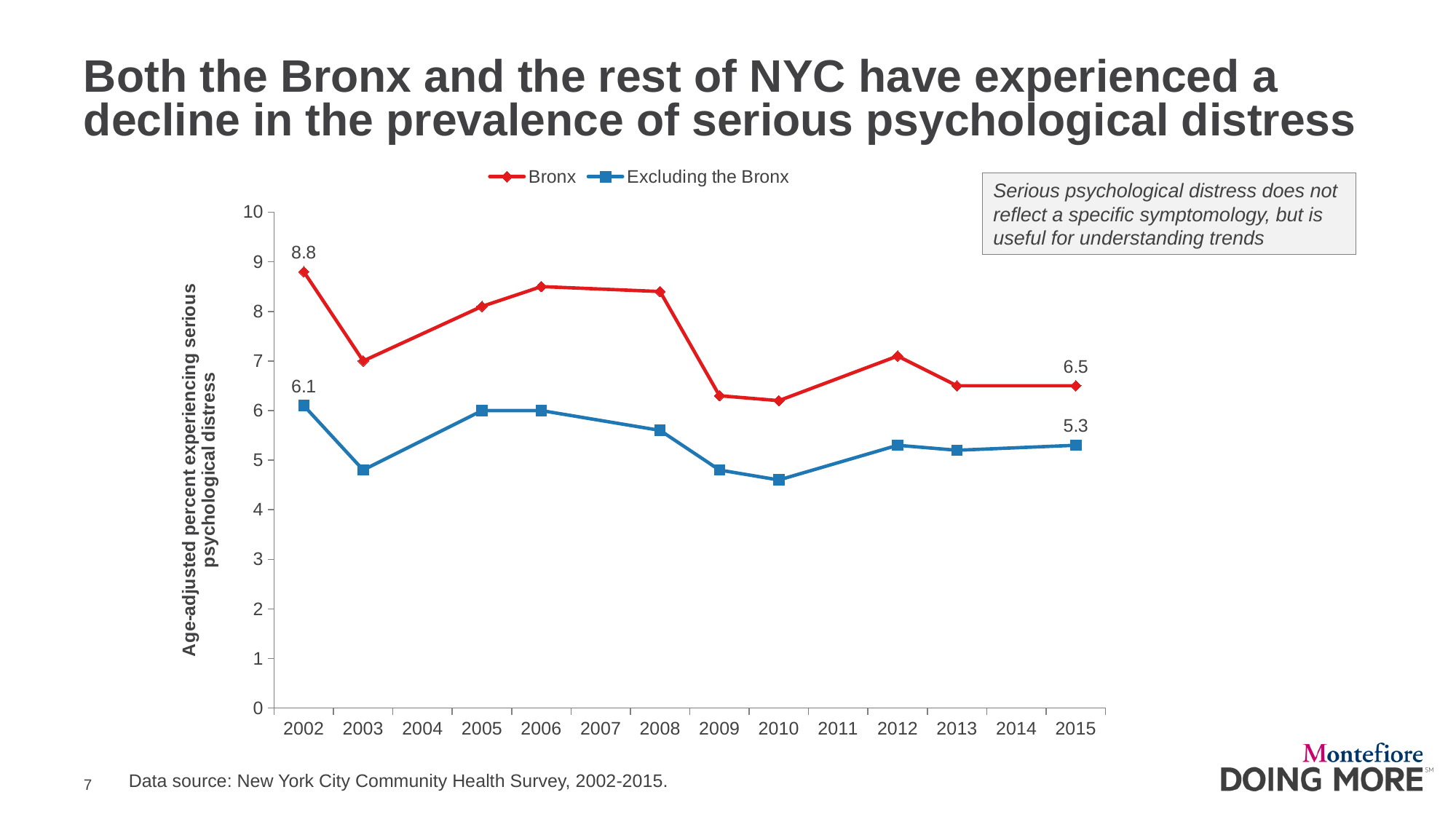
Is the value for the Bronx in 2003 greater or less than 8? less How many series does the legend list? 2 By how much did the Bronx value fall from 2002 to 2015? 2.3 In which year does the Bronx series reach its highest value? 2002 What is the value for the Bronx in 2002? 8.8 What is the difference between the Bronx and Excluding the Bronx values in 2015? 1.2 Is the value for Excluding the Bronx in 2010 greater or less than 5? less What is the value for Excluding the Bronx in 2015? 5.3 Which series has the higher value in 2002, Bronx or Excluding the Bronx? Bronx What kind of chart is shown on the slide? line chart What is the value for Excluding the Bronx in 2002? 6.1 What is the value for the Bronx in 2015? 6.5